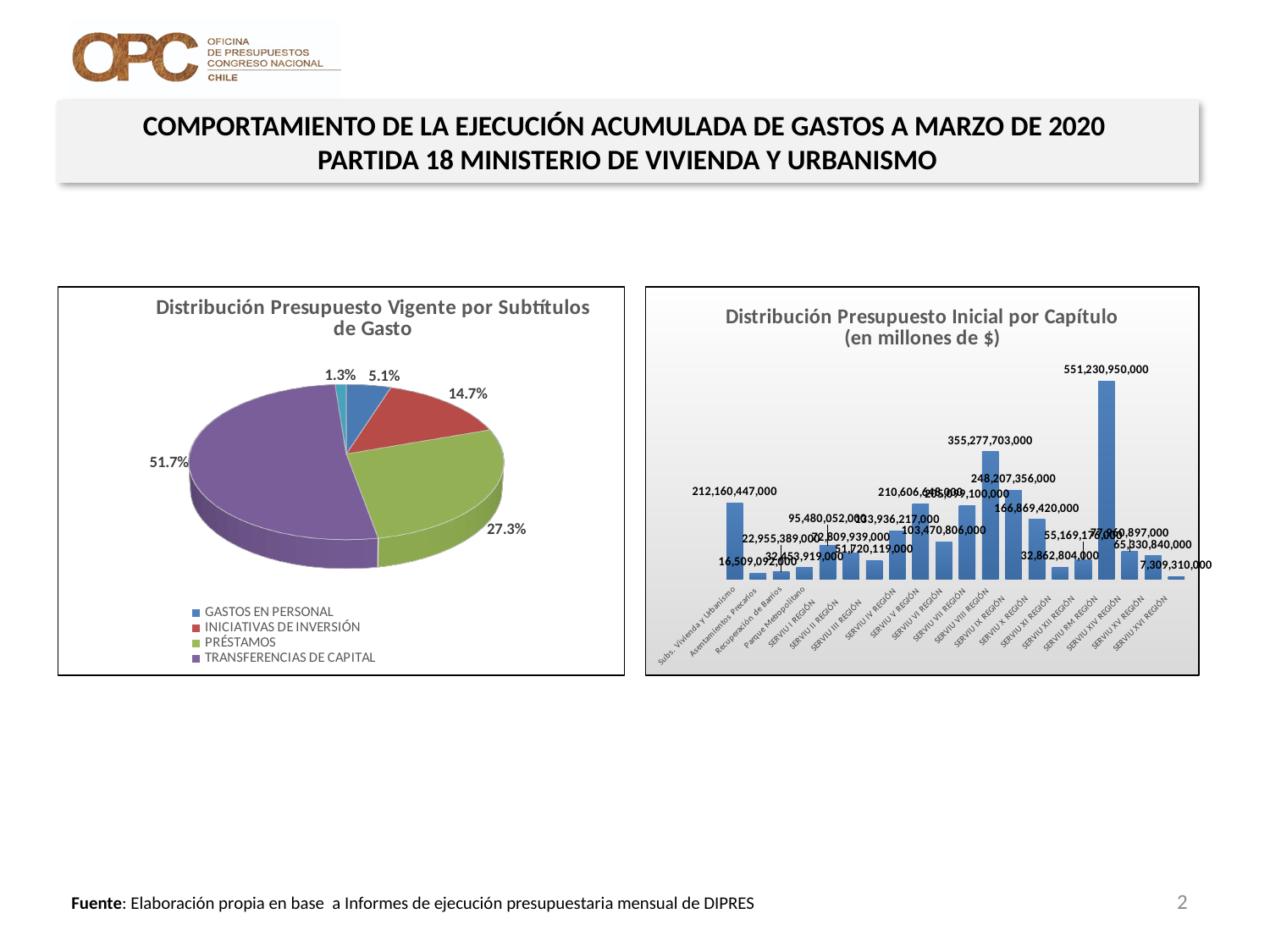
What kind of chart is the 'Distribución Presupuesto Inicial por Capítulo' chart on the right? Bar chart In the 'Distribución Presupuesto Inicial por Capítulo' bar chart, what is the difference between the values for SERVIU RM REGIÓN and SERVIU VIII REGIÓN? 195,953,247,000 In the 'Distribución Presupuesto Inicial por Capítulo' bar chart, which is larger: SERVIU IX REGIÓN or SERVIU X REGIÓN? SERVIU IX REGIÓN In the 'Distribución Presupuesto Vigente por Subtítulos de Gasto' pie chart, what share does TRANSFERENCIAS DE CAPITAL have? 51.7% In the 'Distribución Presupuesto Inicial por Capítulo' bar chart, which capítulo has the highest value? SERVIU RM REGIÓN In the 'Distribución Presupuesto Vigente por Subtítulos de Gasto' pie chart, what share does PRÉSTAMOS have? 27.3% In the 'Distribución Presupuesto Vigente por Subtítulos de Gasto' pie chart, what share does INICIATIVAS DE INVERSIÓN have? 14.7% In the 'Distribución Presupuesto Vigente por Subtítulos de Gasto' pie chart, which category has the largest slice? TRANSFERENCIAS DE CAPITAL In the 'Distribución Presupuesto Inicial por Capítulo' bar chart, which capítulo has the lowest value? SERVIU XVI REGIÓN In the 'Distribución Presupuesto Inicial por Capítulo' bar chart, what is the value for SERVIU VIII REGIÓN? 355,277,703,000 What kind of chart is the 'Distribución Presupuesto Vigente por Subtítulos de Gasto' chart on the left? Pie chart How many entries does the legend of the 'Distribución Presupuesto Vigente por Subtítulos de Gasto' pie chart list? 4